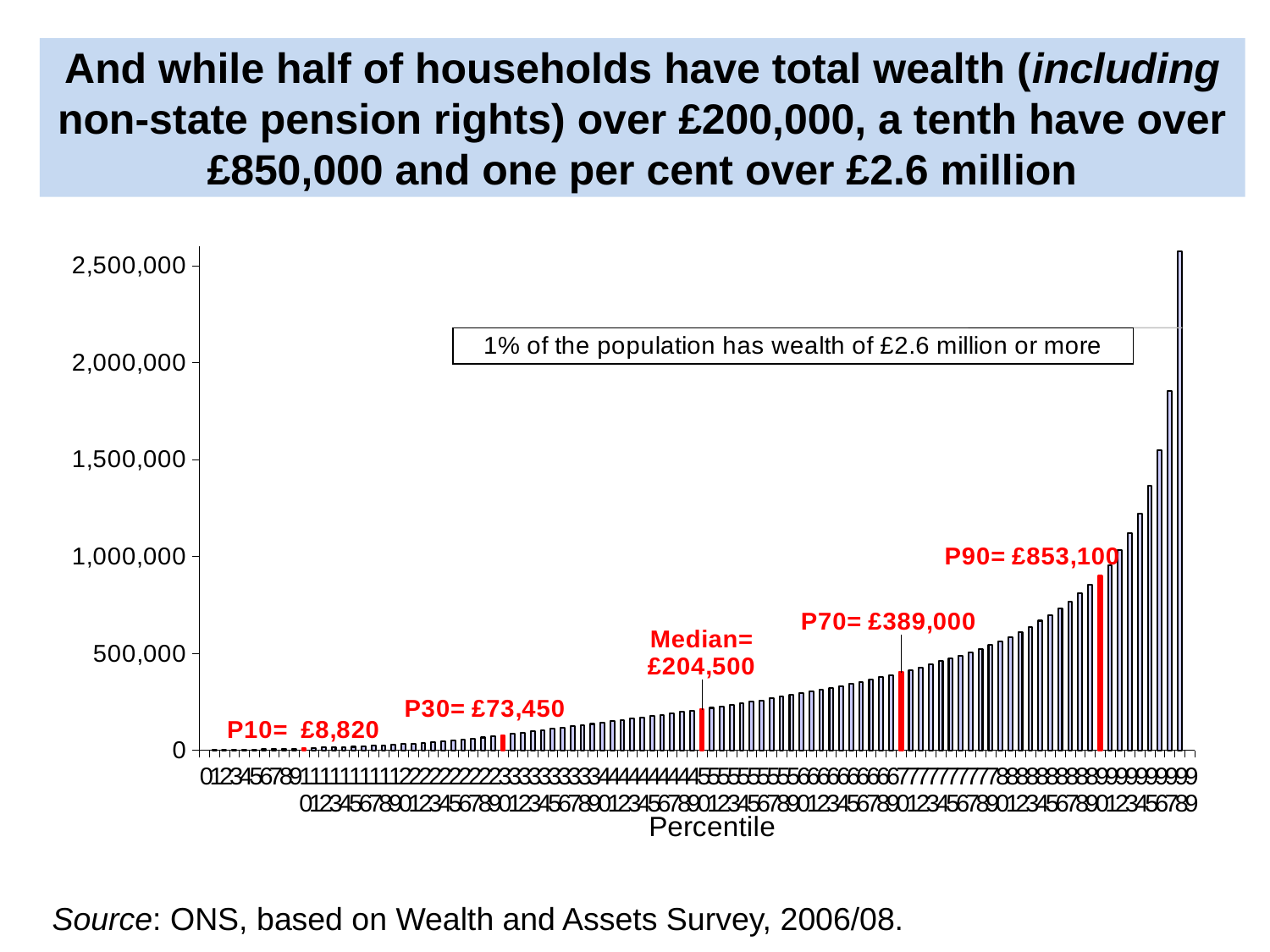
What is the median total wealth shown on the chart? £204,500 What kind of chart is shown on the slide? bar chart What is the value shown for P70 on the chart? £389,000 What is the value shown for P30 on the chart? £73,450 Do the values rise or fall as the percentile increases along the x axis? rise What is the difference between the P90 value and the P70 value? £464,100 What is the value shown for P90 on the chart? £853,100 What is the title of the x axis of the chart? Percentile Which is larger, the value at P70 or the value at P30? P70 What is the difference between the median value and the P30 value? £131,050 What is the value shown for P10 on the chart? £8,820